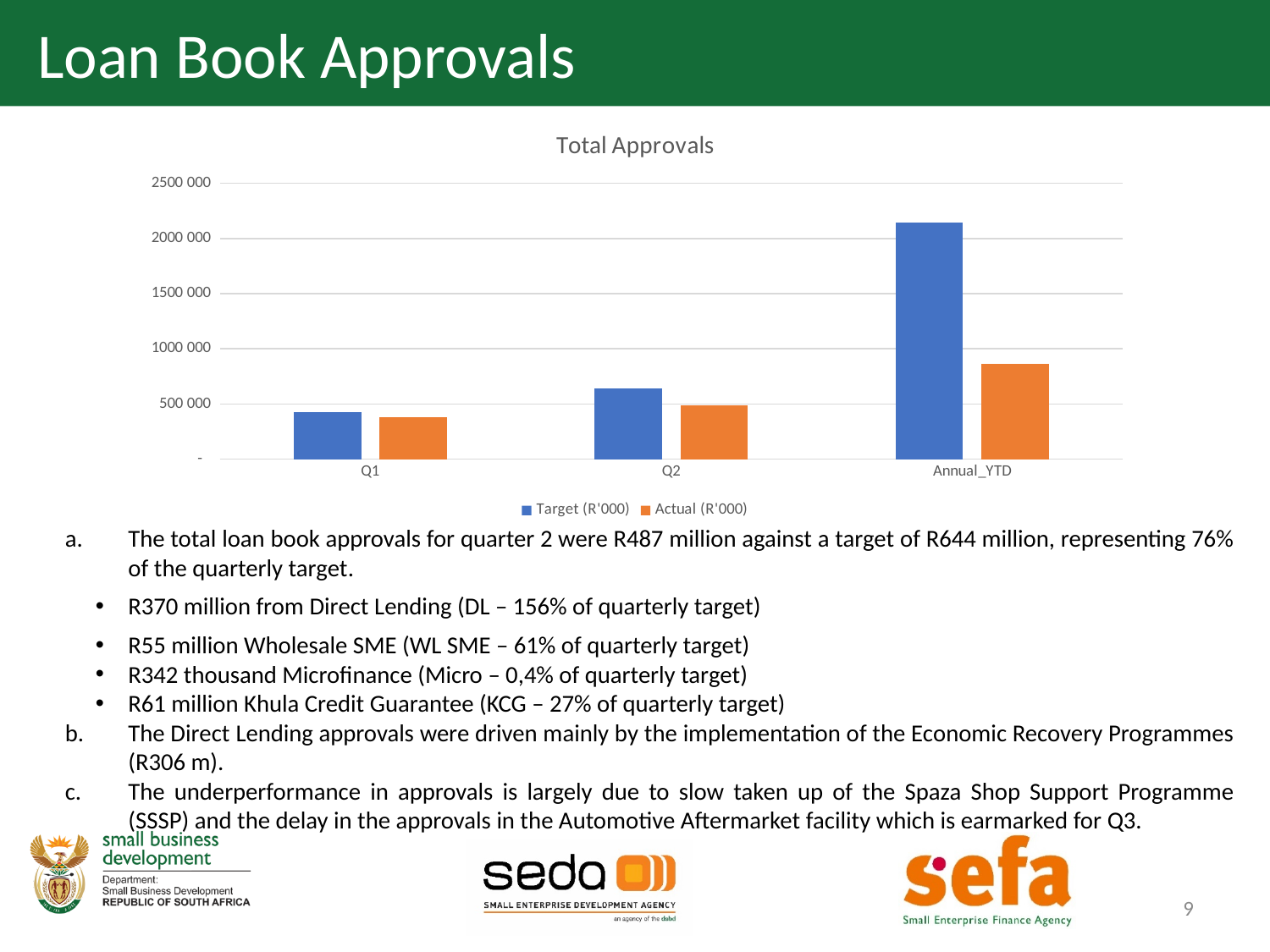
What kind of chart is shown on the slide? bar chart Which category has the highest Target (R'000) value? Annual_YTD What are the two series named in the legend? Target (R'000) and Actual (R'000) For Annual_YTD, which is larger: Target (R'000) or Actual (R'000)? Target (R'000) How many series does the chart legend list? 2 For Q2, which is larger: Target (R'000) or Actual (R'000)? Target (R'000) What is the title of the chart? Total Approvals Is the Target (R'000) value for Annual_YTD greater or less than 2000 000? greater How many categories are shown on the x axis? 3 Do the Target (R'000) values rise or fall from Q1 to Annual_YTD? rise Is the Actual (R'000) value for Annual_YTD greater or less than 1000 000? less Which category has the lowest Actual (R'000) value? Q1